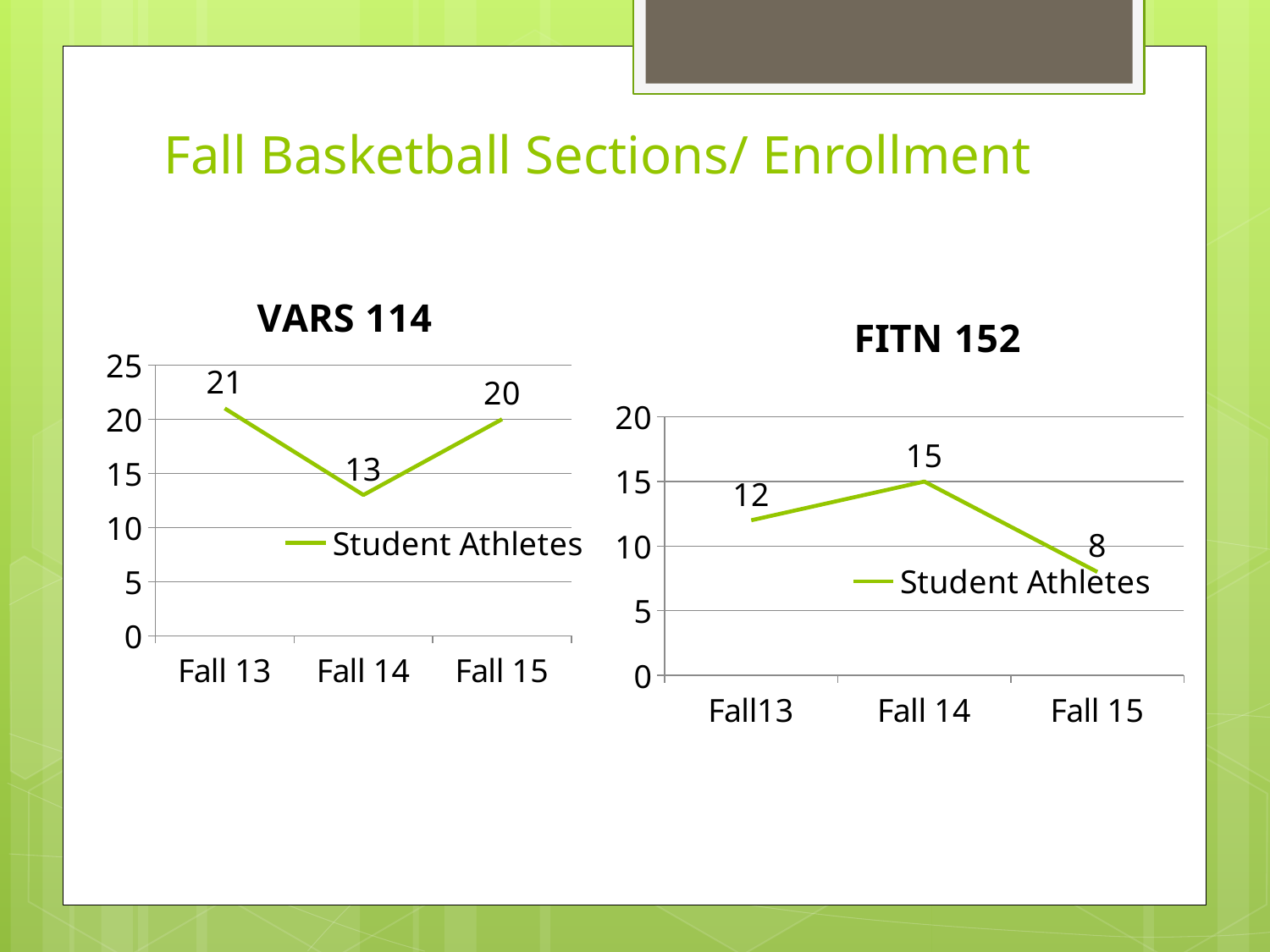
In the FITN 152 chart, do the values rise or fall from Fall 14 to Fall 15? Fall In the FITN 152 chart, which is larger, the value for Fall13 or the value for Fall 14? Fall 14 In the VARS 114 chart, what is the difference between the Fall 13 and Fall 14 values? 8 What kind of chart is the VARS 114 chart? Line chart In the VARS 114 chart, which period has the highest number of Student Athletes? Fall 13 In the FITN 152 chart, which period has the lowest number of Student Athletes? Fall 15 In the FITN 152 chart, what is the value for Student Athletes in Fall 15? 8 In the FITN 152 chart, how many series does the legend list? 1 In the VARS 114 chart, how many periods are plotted on the x axis? 3 In the VARS 114 chart, what is the value for Student Athletes in Fall 14? 13 What is the legend entry shown in the VARS 114 chart? Student Athletes In the FITN 152 chart, what is the difference between the Fall 14 and Fall 15 values? 7